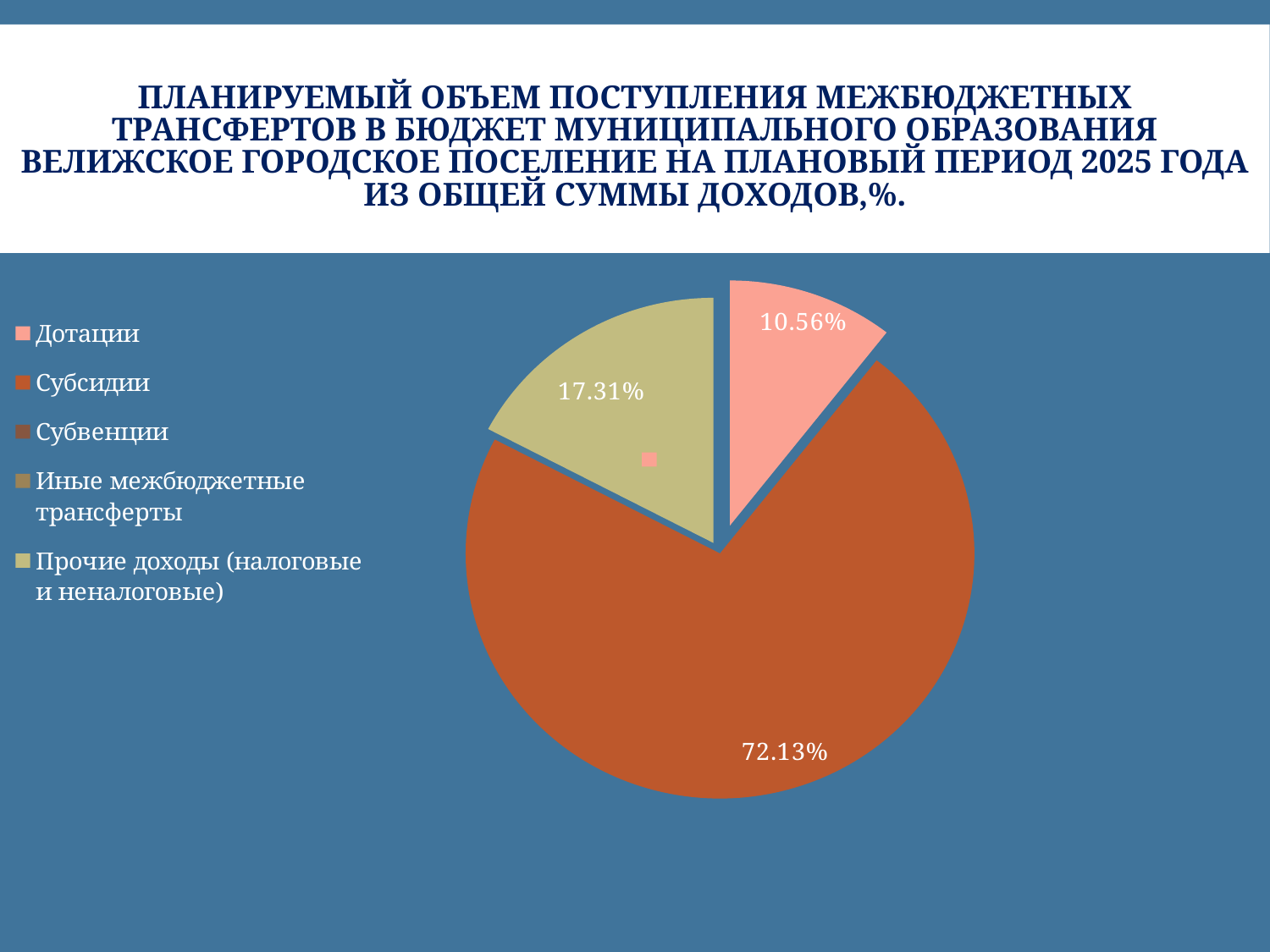
What percentage is shown for Субсидии? 72.13% Is the share for Субсидии greater or less than 50%? greater What type of chart is shown on the slide? Pie chart Which is larger, the share for Дотации or the share for Субсидии? Субсидии What percentage is shown for Дотации? 10.56% How many entries does the legend list? 5 Which labeled slice of the pie is the smallest? Дотации What is the difference in percentage points between Субсидии and Дотации? 61.57% Which category has the largest slice of the pie? Субсидии How many slices of the pie have a percentage label? 3 What colour is the legend marker for Дотации? Pink What is the difference between the largest slice and the second-largest slice? 54.82%